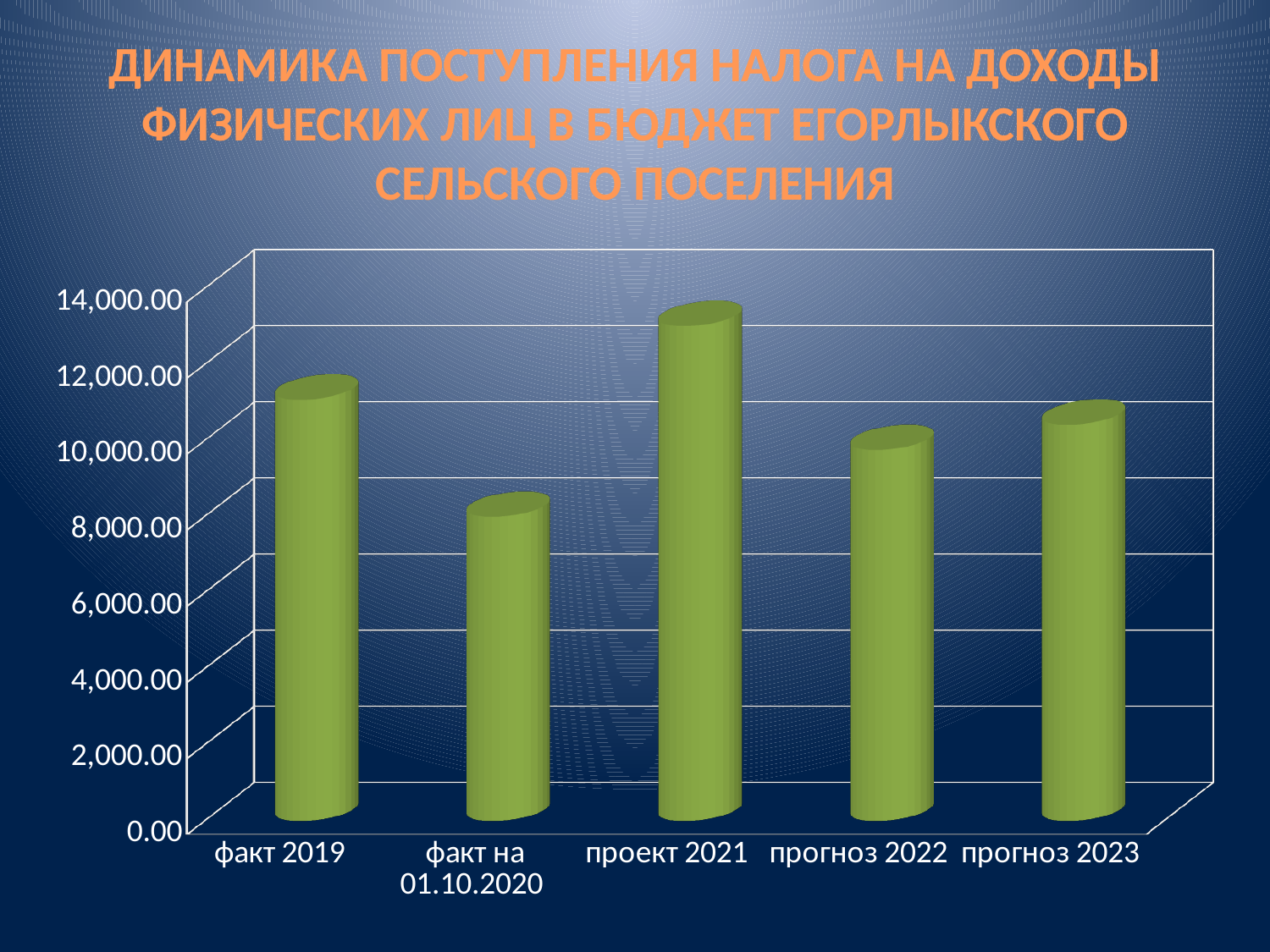
What kind of chart is shown on the slide? bar chart Which category has the highest value in the chart? проект 2021 Is the value for прогноз 2022 greater or less than 12,000.00? less Which is larger: the value for проект 2021 or the value for прогноз 2022? проект 2021 Which category has the lowest value in the chart? факт на 01.10.2020 Is the value for факт на 01.10.2020 greater or less than 10,000.00? less What colour are the bars in the chart? green How many categories are shown on the x axis of the chart? 5 Is the value for факт 2019 greater or less than 10,000.00? greater Which is larger: the value for факт 2019 or the value for факт на 01.10.2020? факт 2019